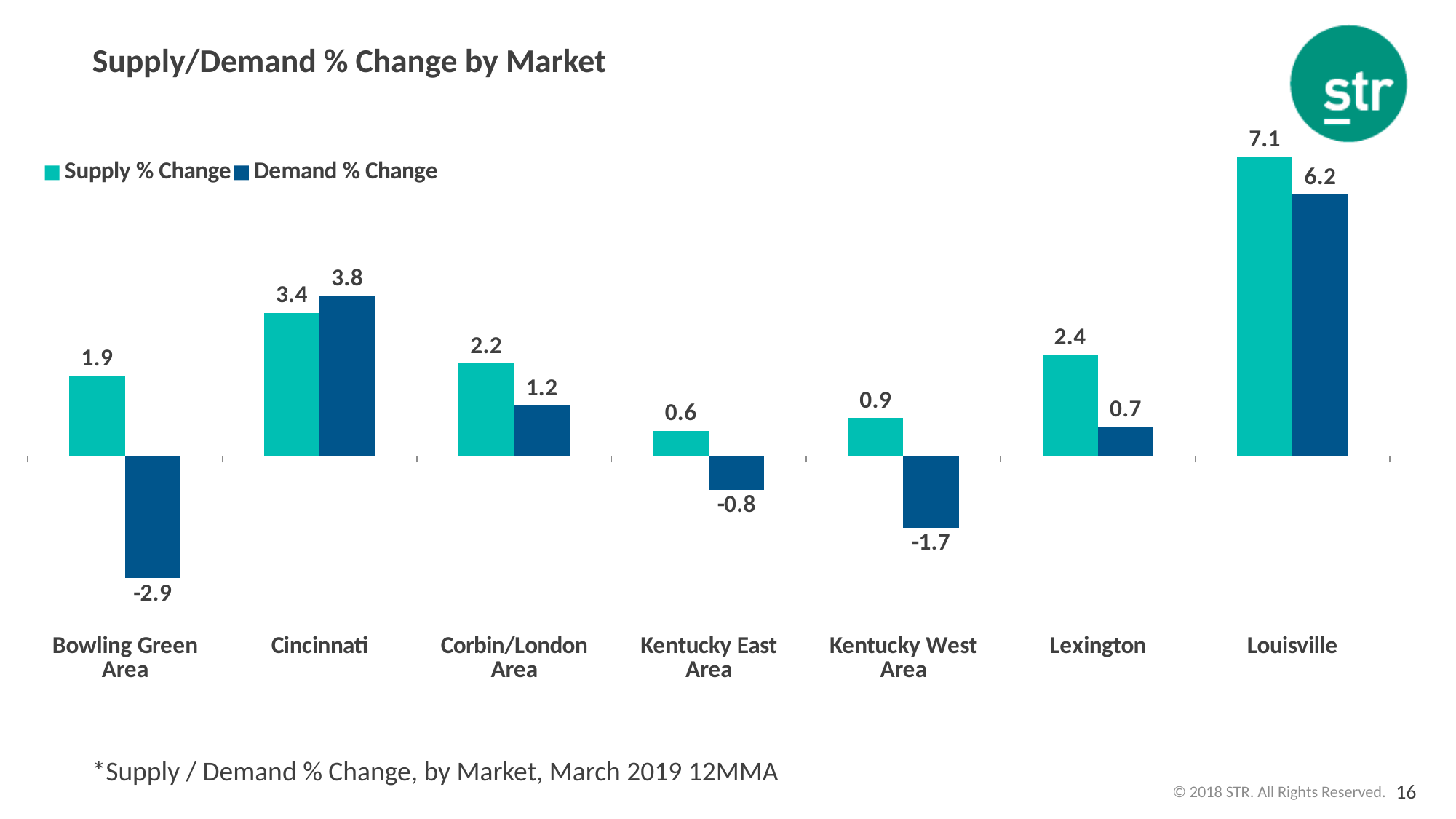
What kind of chart is shown on the slide? Bar chart What is the difference between the Supply % Change and Demand % Change for Cincinnati? 0.4 How many markets are shown on the chart? 7 How many series does the legend list? 2 Which market has the lowest Demand % Change? Bowling Green Area Which market has the lowest Supply % Change? Kentucky East Area Which is larger for Lexington, the Supply % Change or the Demand % Change? Supply % Change What is the Supply % Change for Louisville? 7.1 What is the Supply % Change for Corbin/London Area? 2.2 Which market has the highest Supply % Change? Louisville What is the Demand % Change for Kentucky West Area? -1.7 What is the Demand % Change for Bowling Green Area? -2.9